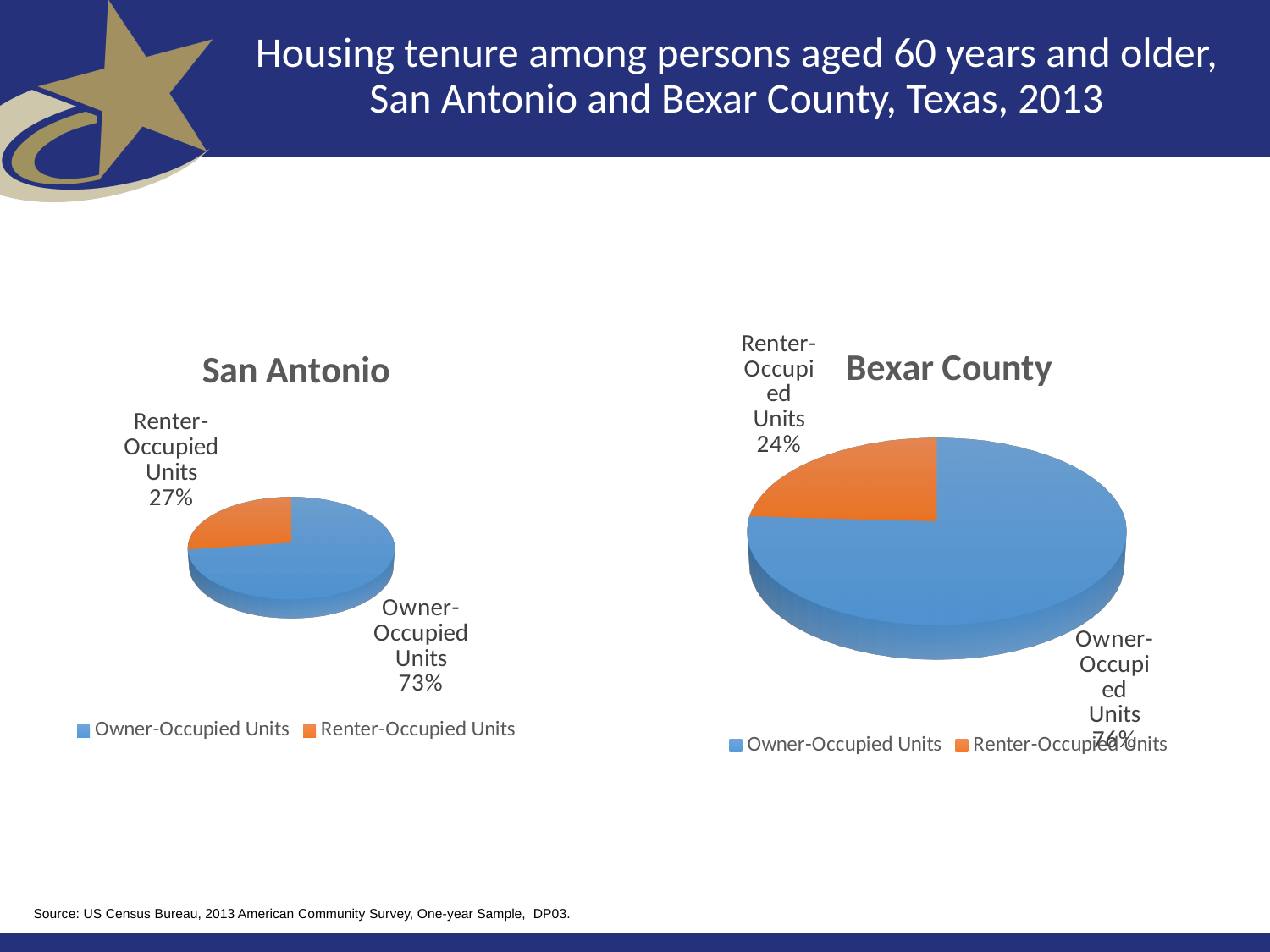
In the San Antonio chart, what share of the pie is Renter-Occupied Units? 27% In the Bexar County chart, what share of the pie is Owner-Occupied Units? 76% In the San Antonio chart, what share of the pie is Owner-Occupied Units? 73% How many entries does the legend of the San Antonio chart list? 2 How many categories does the Bexar County chart show? 2 What kind of chart is the San Antonio chart? Pie chart In the San Antonio chart, what is the difference between the Owner-Occupied Units share and the Renter-Occupied Units share? 46% In the Bexar County chart, which category has the smallest slice? Renter-Occupied Units In the Bexar County chart, what colour is the Renter-Occupied Units slice? Orange Is the Renter-Occupied Units share larger in the San Antonio chart or the Bexar County chart? San Antonio In the San Antonio chart, which category has the largest slice? Owner-Occupied Units